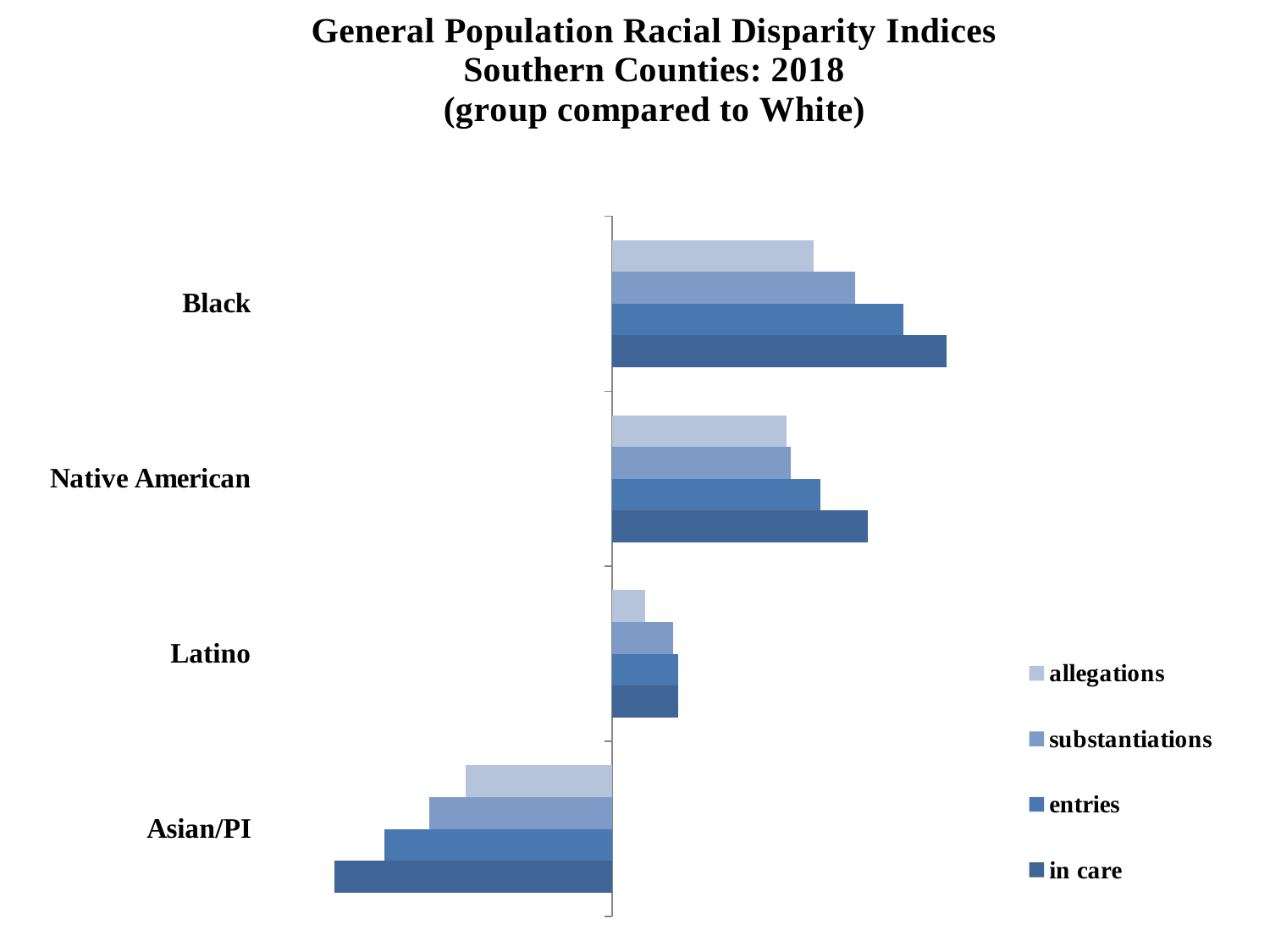
Which group has the highest 'allegations' disparity index? Black Which group has the highest 'in care' disparity index? Black What kind of chart is shown on the slide? bar chart Which is larger, the 'allegations' value for Black or for Native American? Black For the Black group, which series has the largest value? in care Which is larger for the Latino group, 'allegations' or 'in care'? in care How many racial groups are shown on the chart? 4 Which is larger, the 'entries' value for Latino or for Native American? Native American How many series does the legend list? 4 Which group has the lowest 'in care' disparity index? Asian/PI Which group is the only one with bars extending to the left of the axis (negative values)? Asian/PI What year does the chart title refer to? 2018